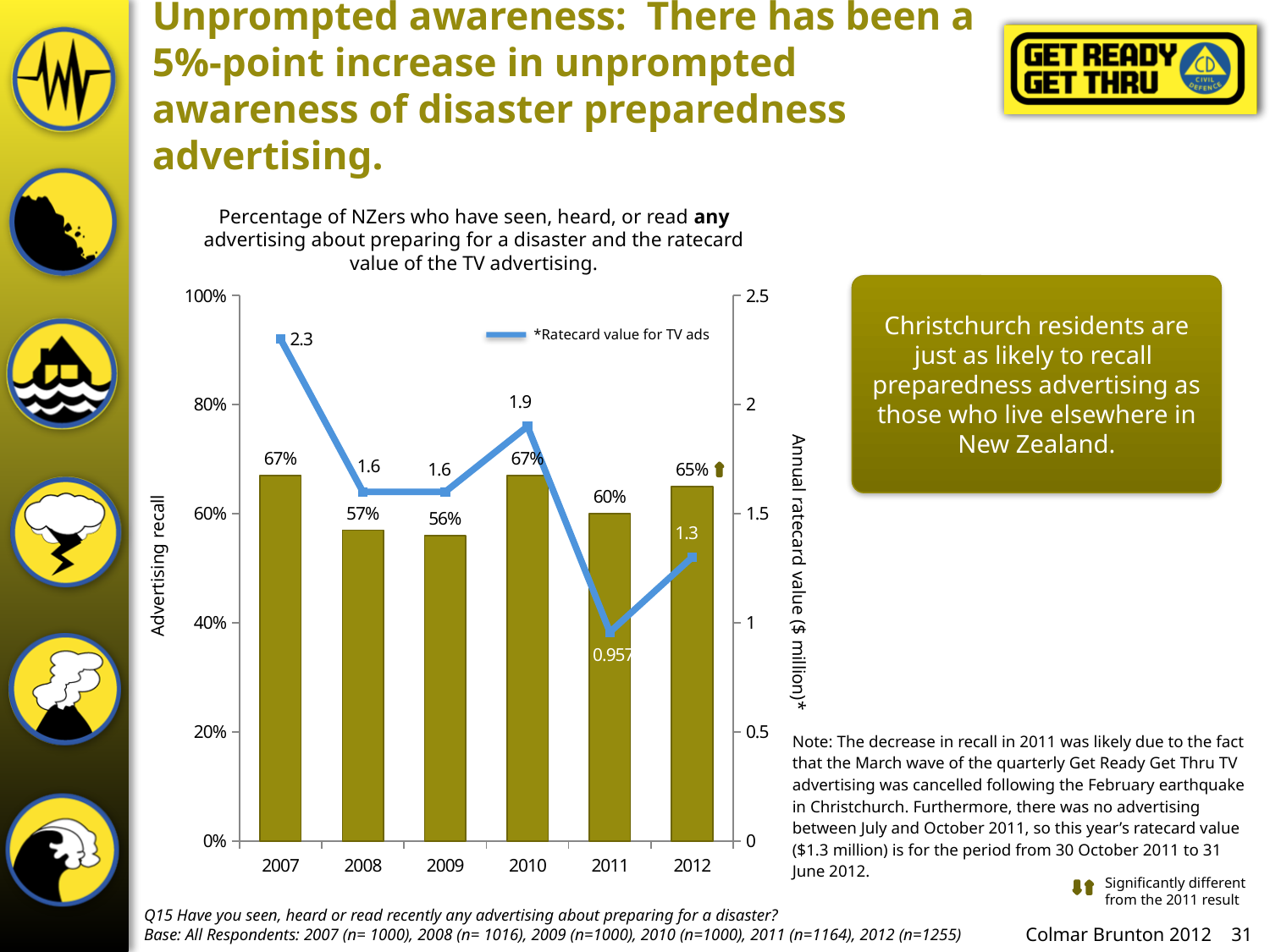
What is the label of the right-hand vertical axis? Annual ratecard value ($ million)* How many years are shown on the x axis of the chart? 6 In which year was the ratecard value for TV ads highest? 2007 What percentage of NZers recalled disaster preparedness advertising in 2012? 65% What is the difference in ratecard value between 2010 and 2008? 0.3 What kind of chart is used to show advertising recall? Bar chart Did the ratecard value for TV ads rise or fall between 2010 and 2011? Fall By how many percentage points did advertising recall change from 2011 to 2012? 5 percentage points Which year had higher advertising recall, 2008 or 2011? 2011 In which year was advertising recall lowest? 2009 What was the advertising recall percentage in 2009? 56% What was the ratecard value for TV ads in 2011? 0.957